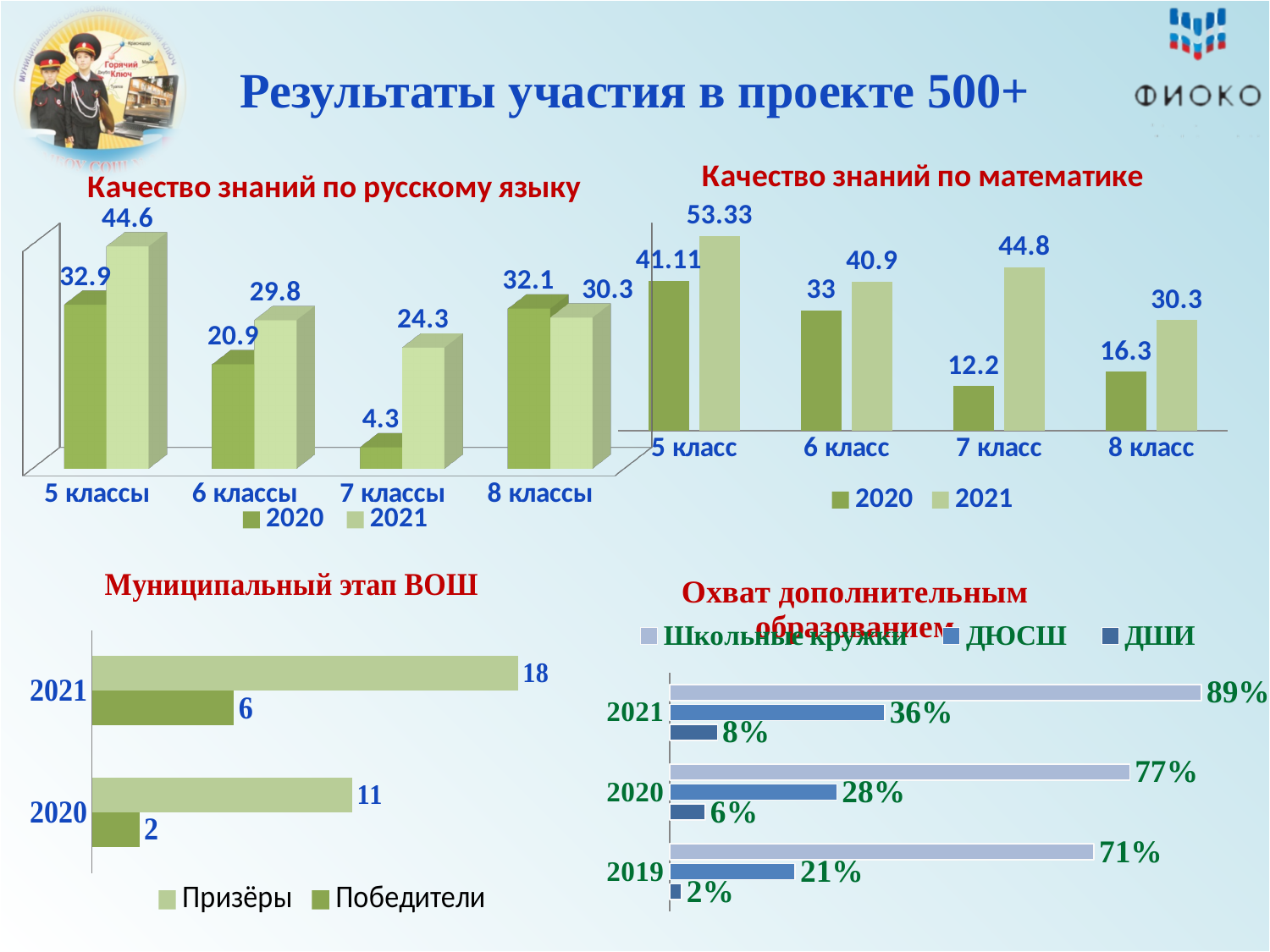
In the chart 'Качество знаний по математике', which class has the highest value for 2021? 5 класс In the chart 'Муниципальный этап ВОШ', how many Победители were there in 2021? 6 In the chart 'Муниципальный этап ВОШ', what is the difference between Призёры in 2021 and Призёры in 2020? 7 In the chart 'Качество знаний по математике', what is the value for 5 класс in 2021? 53.33 In the chart 'Охват дополнительным образованием', do the values for Школьные кружки rise or fall from 2019 to 2021? Rise In the chart 'Качество знаний по математике', how many series does the legend list? 2 In the chart 'Качество знаний по русскому языку', what is the value for 7 классы in 2021? 24.3 In the chart 'Качество знаний по математике', which is larger for 7 класс: the 2020 value or the 2021 value? 2021 In the chart 'Качество знаний по русскому языку', which class group has the lowest value for 2020? 7 классы In the chart 'Качество знаний по русскому языку', what is the difference between the 2021 and 2020 values for 5 классы? 11.7 What kind of chart is 'Муниципальный этап ВОШ'? Bar chart In the chart 'Охват дополнительным образованием', what is the value for ДЮСШ in 2020? 28%